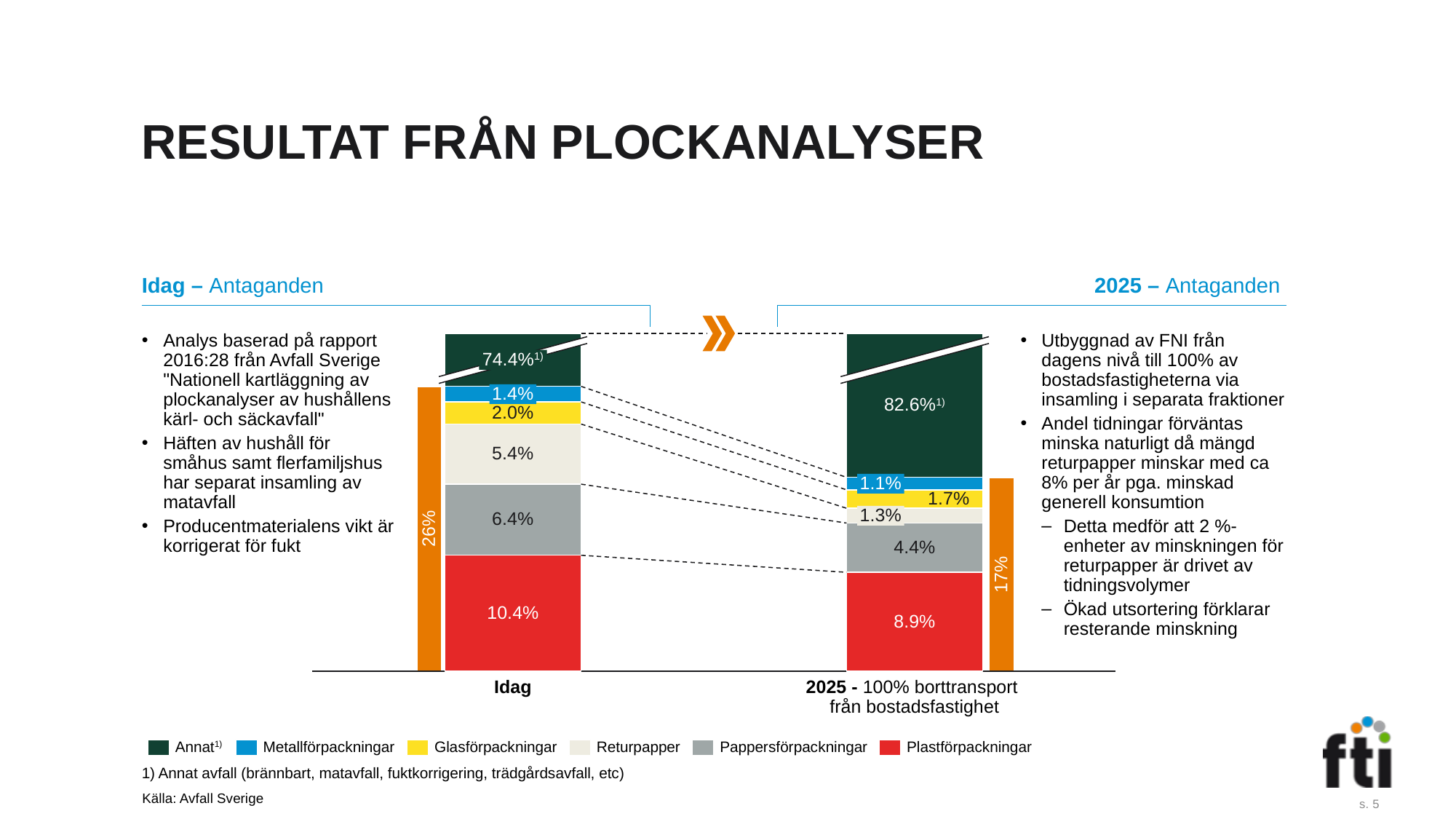
What is the value for Plastförpackningar in the Idag bar? 10.4% What is the difference between the Pappersförpackningar values for Idag and 2025? 2.0% What kind of chart is shown on the slide? Stacked bar chart What is the value for Returpapper in the 2025 bar? 1.3% What is the value for Returpapper in the Idag bar? 5.4% What is the value for Annat in the 2025 bar? 82.6% Which segment is the smallest in the 2025 bar? Metallförpackningar How many series does the legend list? 6 What is the value for Pappersförpackningar in the Idag bar? 6.4% Which segment is the largest in the Idag bar? Annat Is the Glasförpackningar value larger for Idag or for 2025? Idag What is the value for Plastförpackningar in the 2025 bar? 8.9%